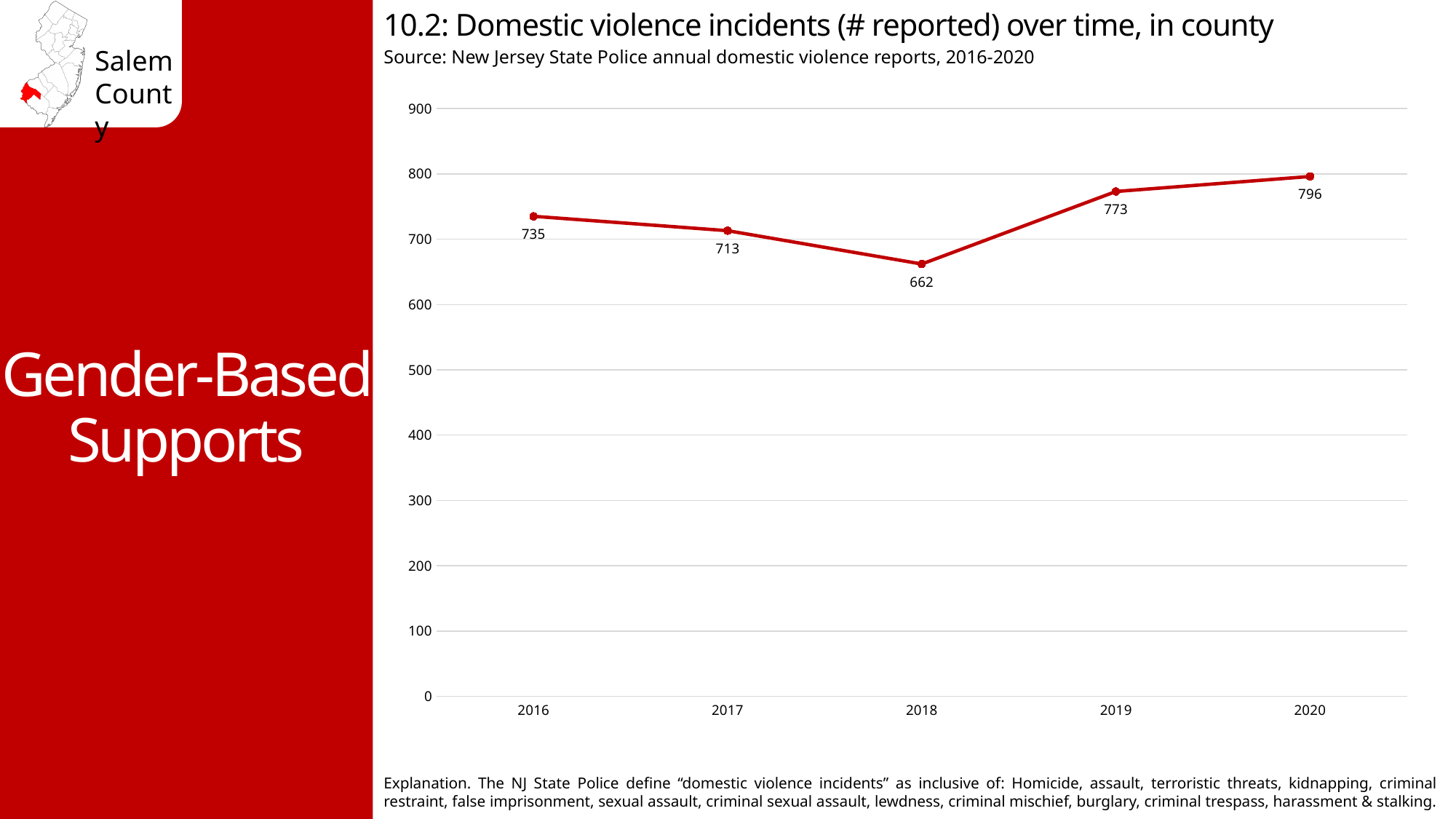
Which year had the lowest number of reported domestic violence incidents? 2018 Which year had the highest number of reported domestic violence incidents? 2020 What value is shown for 2016? 735 By how much did reported incidents change from 2016 to 2017? 22 What was the number of reported domestic violence incidents in 2020? 796 What kind of chart is shown on the slide? line chart How many domestic violence incidents were reported in 2018? 662 Did the number of reported incidents rise or fall from 2018 to 2020? rise How many years are plotted on the chart? 5 Which year had more reported incidents, 2017 or 2019? 2019 Is the value for 2019 greater or less than 700? greater What is the difference between the number of incidents in 2020 and in 2018? 134